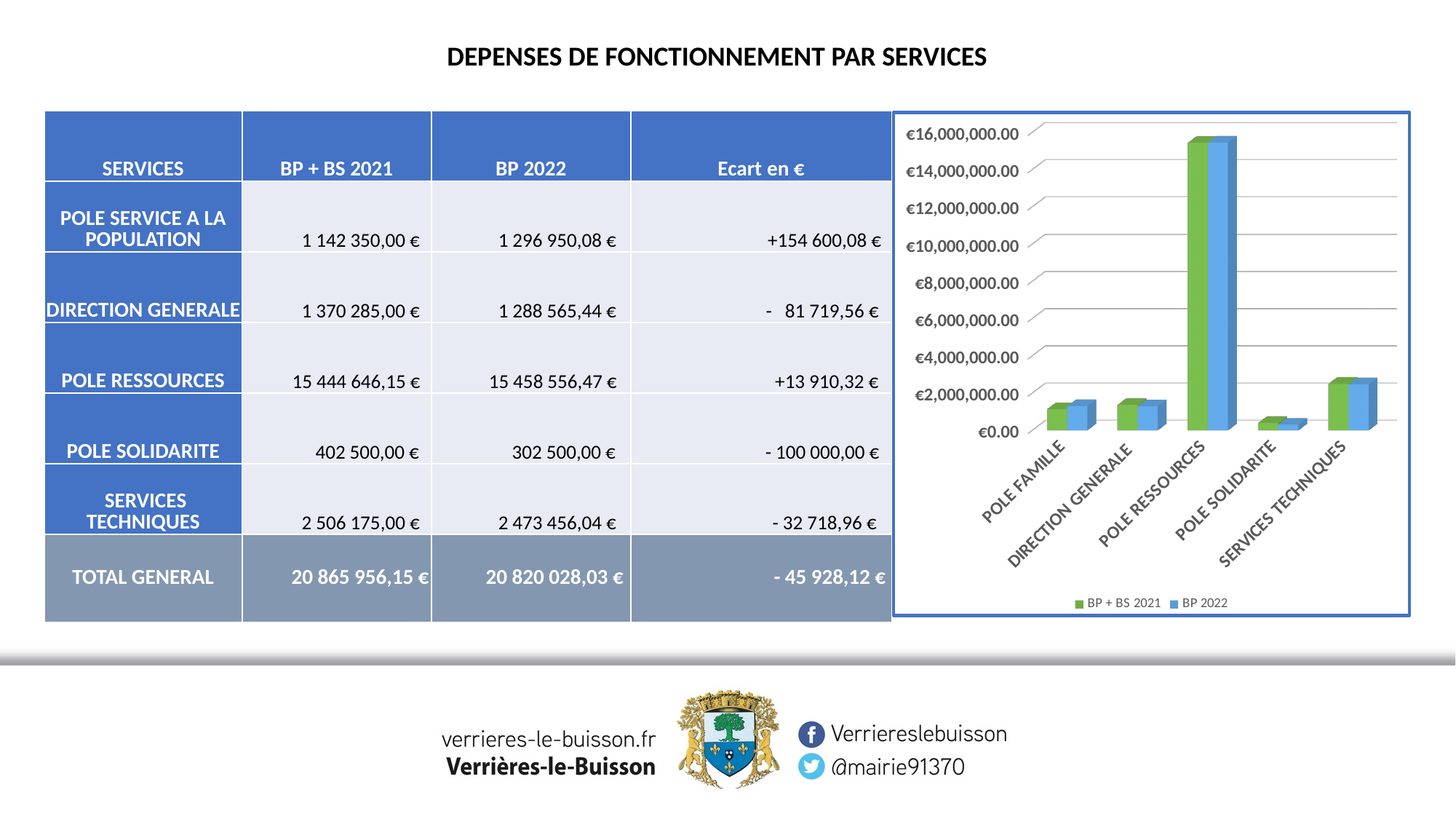
Is the BP 2022 value for POLE SOLIDARITE greater or less than €2,000,000.00? less Is the BP + BS 2021 value for DIRECTION GENERALE greater or less than €2,000,000.00? less Which category has the highest bars in the chart? POLE RESSOURCES What are the two series names listed in the chart legend? BP + BS 2021 and BP 2022 How many series does the chart legend list? 2 How many categories are shown on the x axis of the chart? 5 Which is larger in the chart: the BP 2022 value for POLE RESSOURCES or for SERVICES TECHNIQUES? POLE RESSOURCES What kind of chart is shown on the slide? bar chart Which is larger in the chart: the BP + BS 2021 value for POLE FAMILLE or for POLE SOLIDARITE? POLE FAMILLE Which category has the lowest bars in the chart? POLE SOLIDARITE Is the BP + BS 2021 value for POLE RESSOURCES greater or less than €14,000,000.00? greater Which colour represents the BP 2022 series in the chart? blue